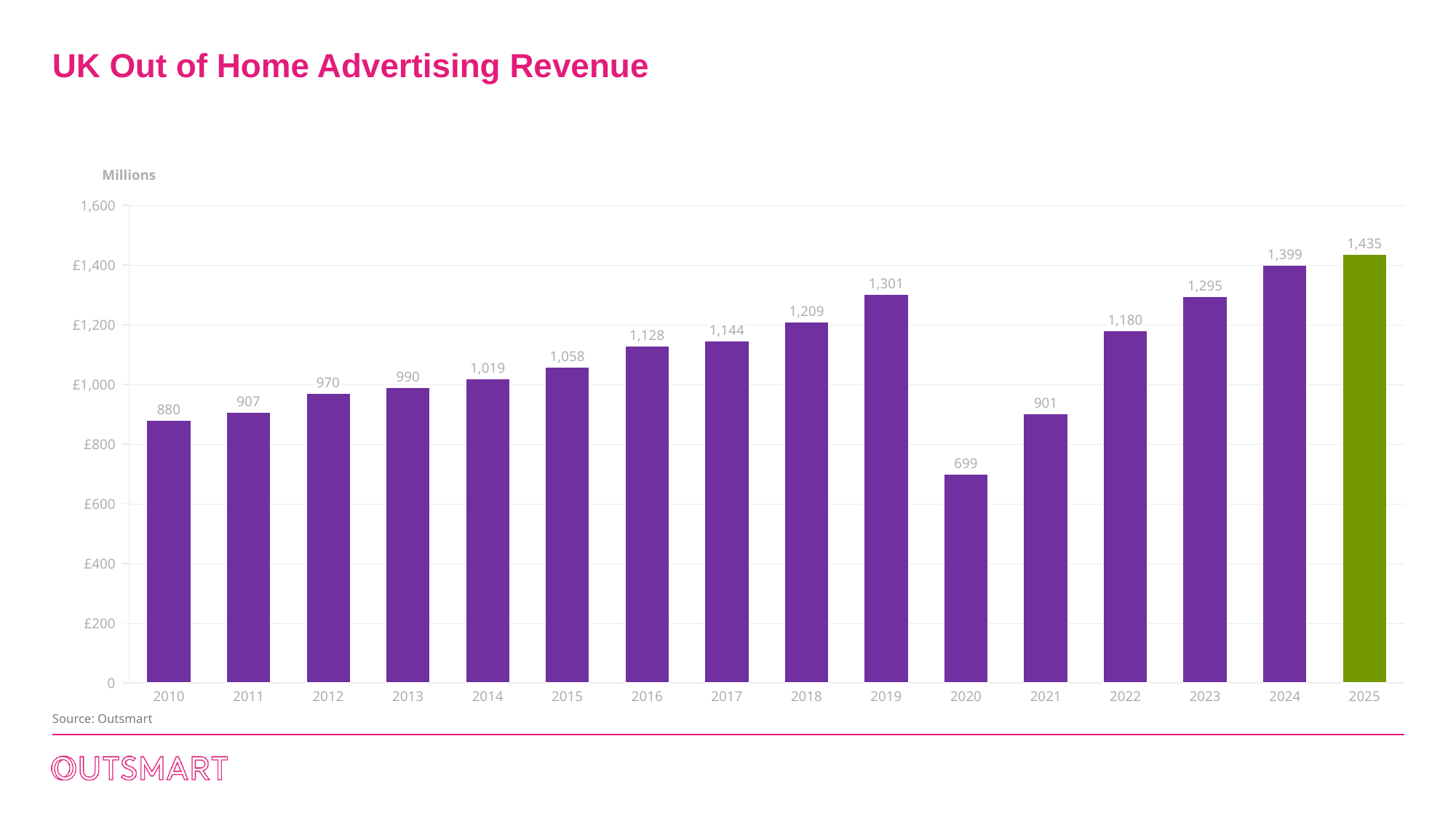
Is the value for 2021 greater or less than £1,000? less What is the UK Out of Home advertising revenue for 2019? 1,301 How many years are shown on the x axis? 16 What is the value shown for 2020? 699 What is the difference between the 2024 and 2023 values? 104 What is the difference between the 2019 and 2020 values? 602 What is the value shown for 2025? 1,435 What kind of chart is shown on the slide? bar chart Which is larger, the value for 2018 or the value for 2022? 2018 Which year has the highest revenue? 2025 Which year has the lowest revenue? 2020 Do the values rise or fall from 2010 to 2019? rise